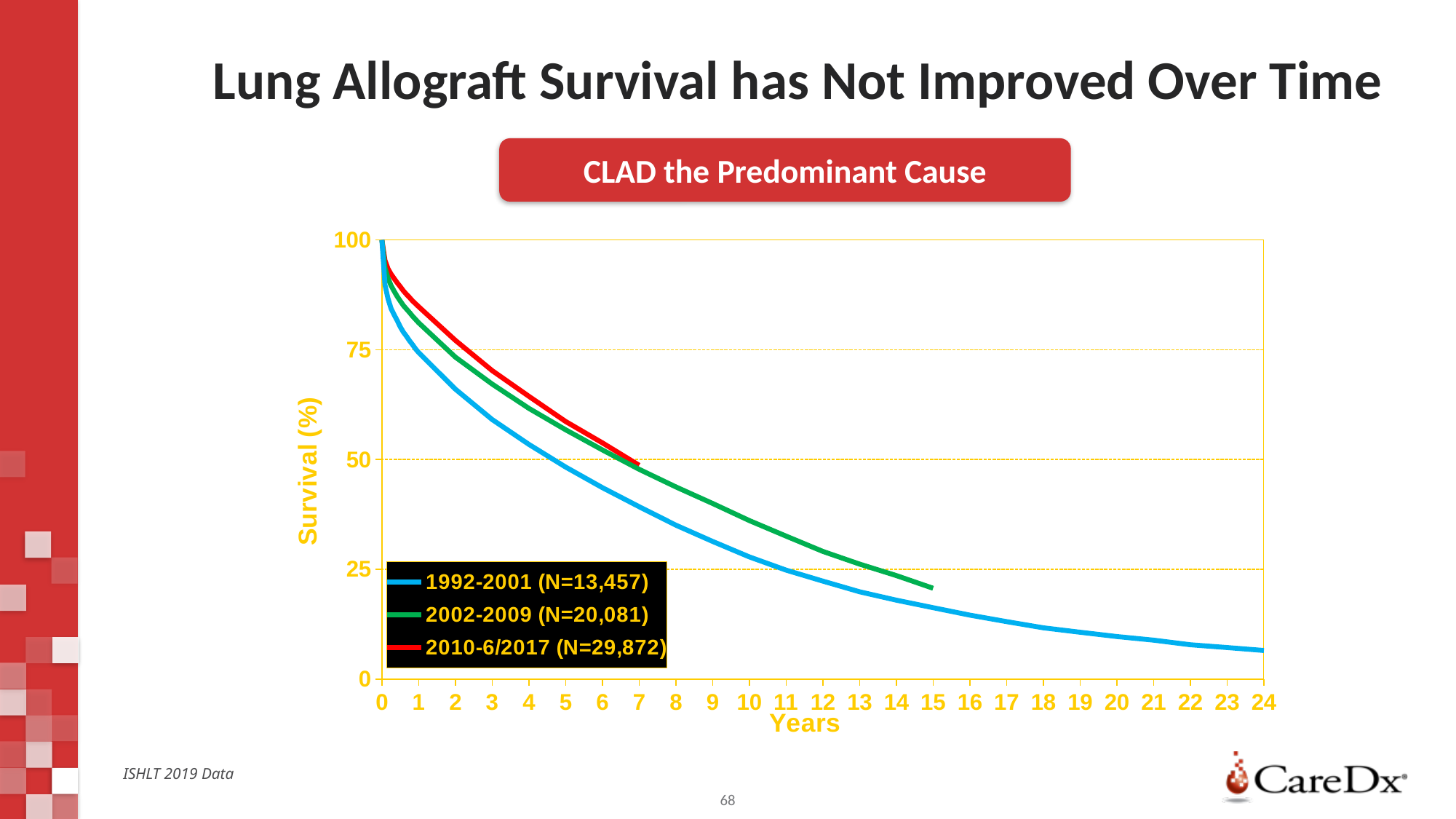
What is the label of the y axis? Survival (%) How many series does the legend list? 3 Which cohort has the lowest survival at year 5? 1992-2001 At year 5, which cohort has higher survival, 1992-2001 or 2002-2009? 2002-2009 Is the survival value for the 1992-2001 cohort at year 24 greater or less than 25? less Is the survival value for the 2002-2009 cohort at year 10 greater or less than 50? less What kind of chart is shown on the slide? Line chart Which cohort's curve extends furthest along the Years axis? 1992-2001 What is the label of the x axis? Years Is the survival value for the 1992-2001 cohort at year 2 greater or less than 50? greater Do the survival curves rise or fall as years increase? Fall